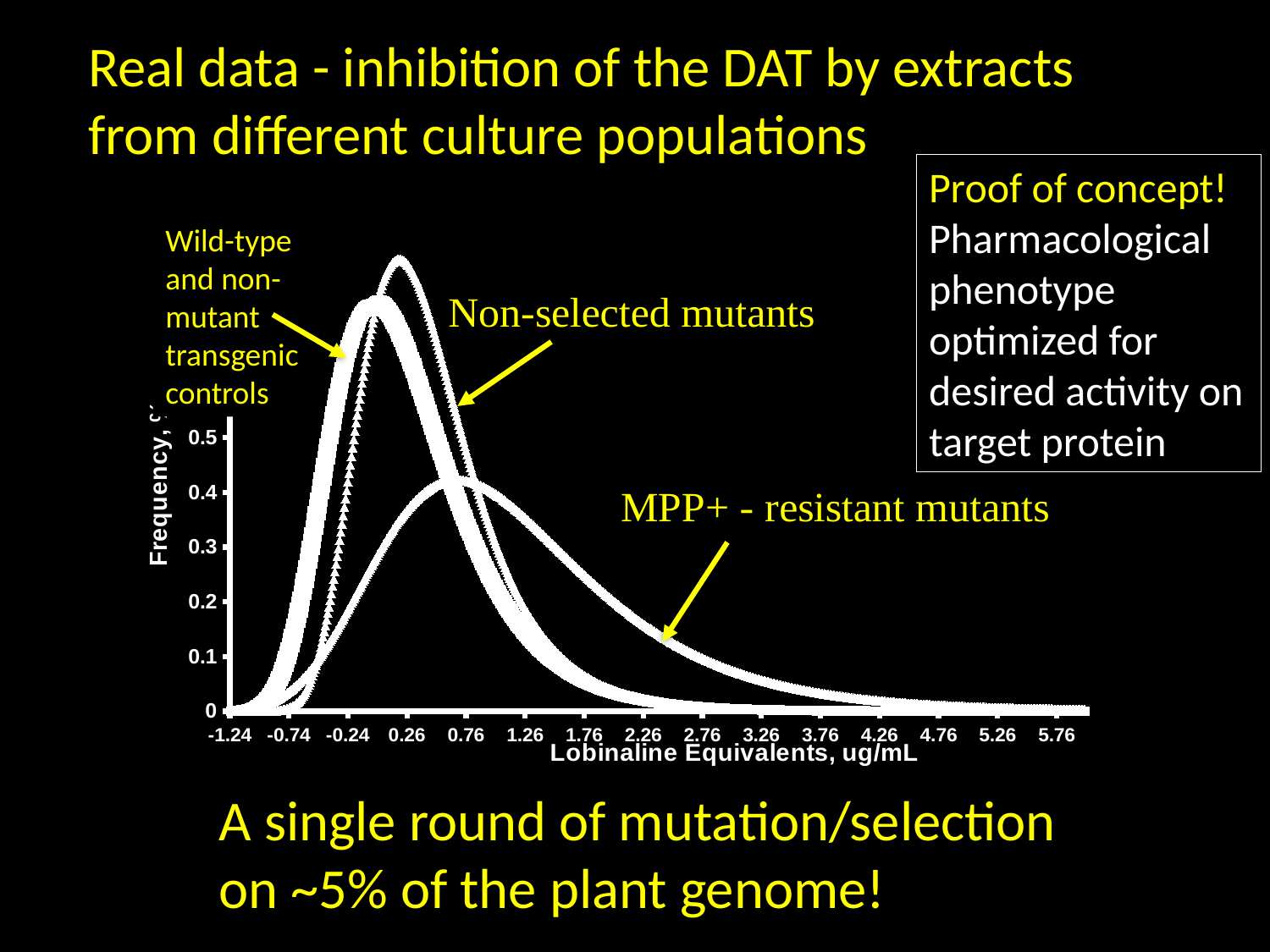
What kind of chart is shown on the slide? line chart Which curve has the lowest peak frequency? MPP+ - resistant mutants Is the peak frequency of the MPP+ - resistant mutants curve greater or less than 0.5? less Which curve peaks furthest to the right along the x axis (highest Lobinaline Equivalents)? MPP+ - resistant mutants What is the lowest value shown on the x axis? -1.24 Is the peak frequency of the Wild-type and non-mutant transgenic controls curve greater or less than 0.4? greater What is the highest value shown on the x axis? 5.76 Which curve has the highest peak frequency? Non-selected mutants Is the peak frequency of the MPP+ - resistant mutants curve greater or less than 0.3? greater How many curves (culture populations) are plotted on the chart? 4 What is the label of the x axis of the chart? Lobinaline Equivalents, ug/mL